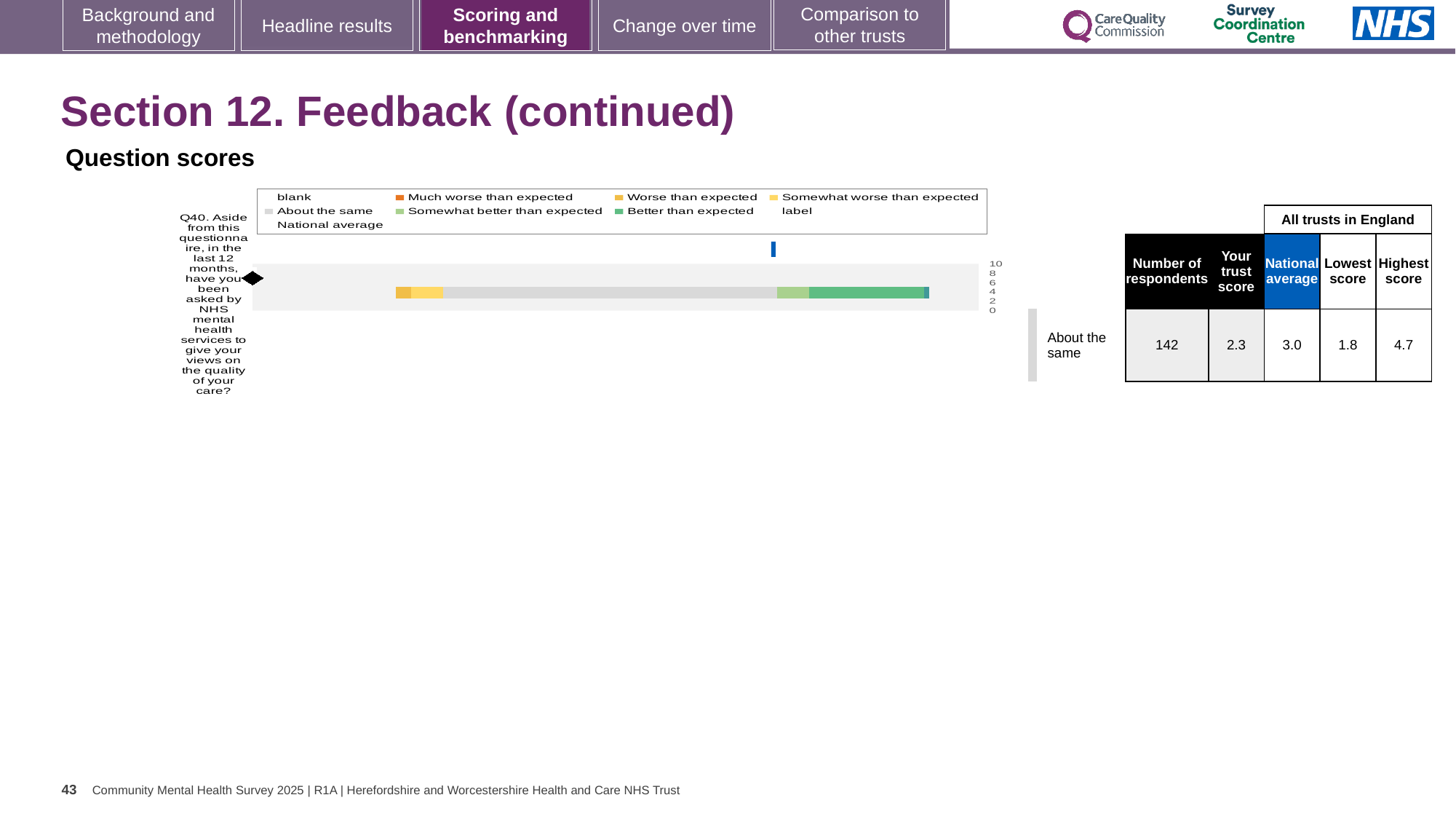
Which legend entry is shown in orange? Much worse than expected Which question number is plotted in the chart? Q40 What is the difference between the national average and the trust score for Q40? 0.7 How many question categories are plotted in the chart? 1 In the table next to the chart, what is the lowest score among all trusts in England for Q40? 1.8 In the table next to the chart, what is the highest score among all trusts in England for Q40? 4.7 How many entries does the chart legend list? 9 Which is larger for Q40, the trust score or the national average? national average In the table next to the chart, what is the number of respondents for Q40? 142 In the table next to the chart, what is the trust's score for Q40? 2.3 In the table next to the chart, what is the national average for Q40? 3.0 What kind of chart is shown on the slide? bar chart